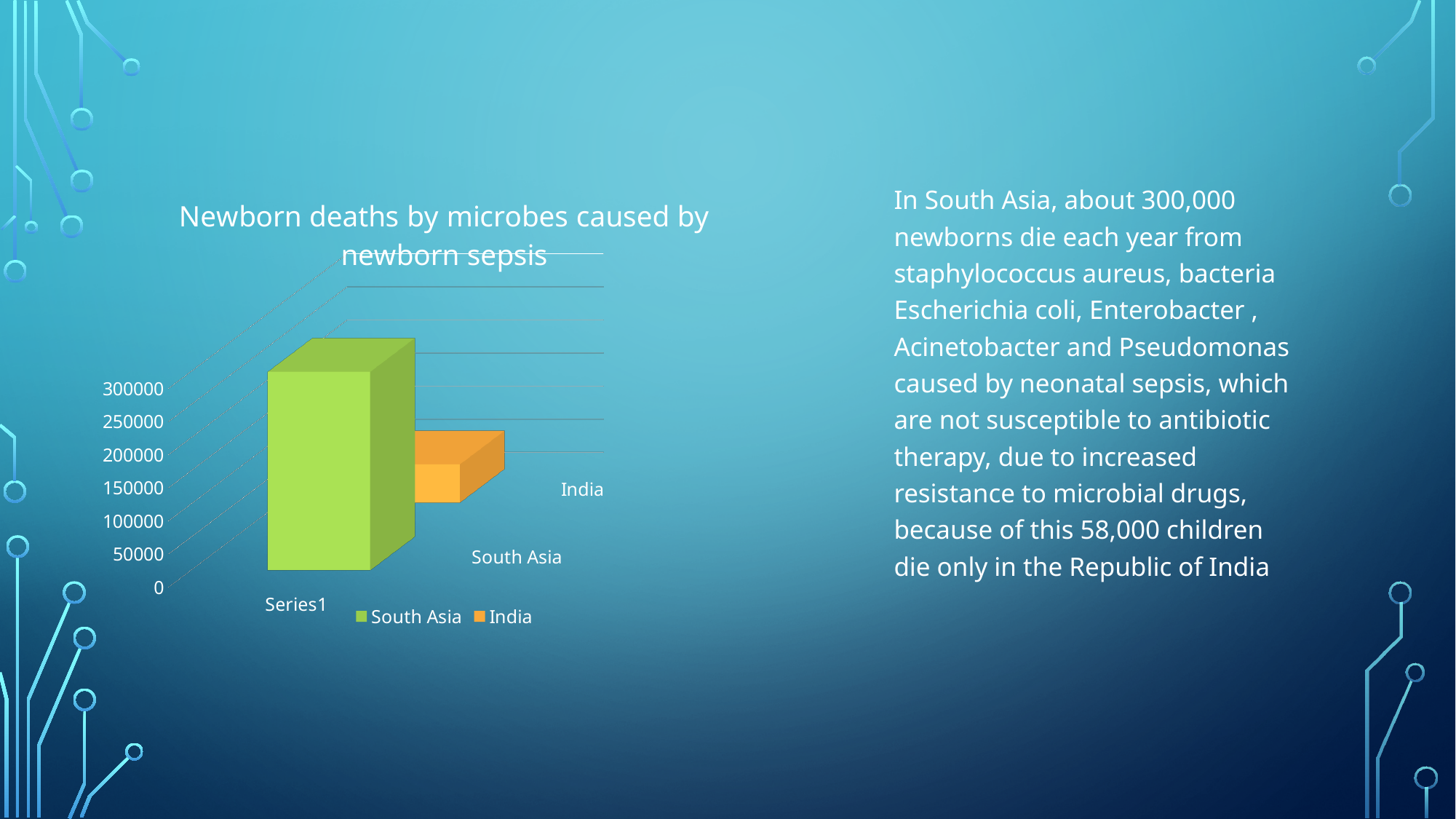
Is the value for South Asia greater or less than 250000? greater What kind of chart is shown on the slide? bar chart Is the value for South Asia greater or less than 200000? greater What is the title of the chart? Newborn deaths by microbes caused by newborn sepsis How many categories are shown on the x axis of the chart? 1 Which series has the lowest value in the chart? India What colour is the South Asia bar in the chart? green Which series has the highest value in the chart? South Asia Is the value for India greater or less than 100000? less How many series does the chart legend list? 2 Which is larger, the value for South Asia or the value for India? South Asia